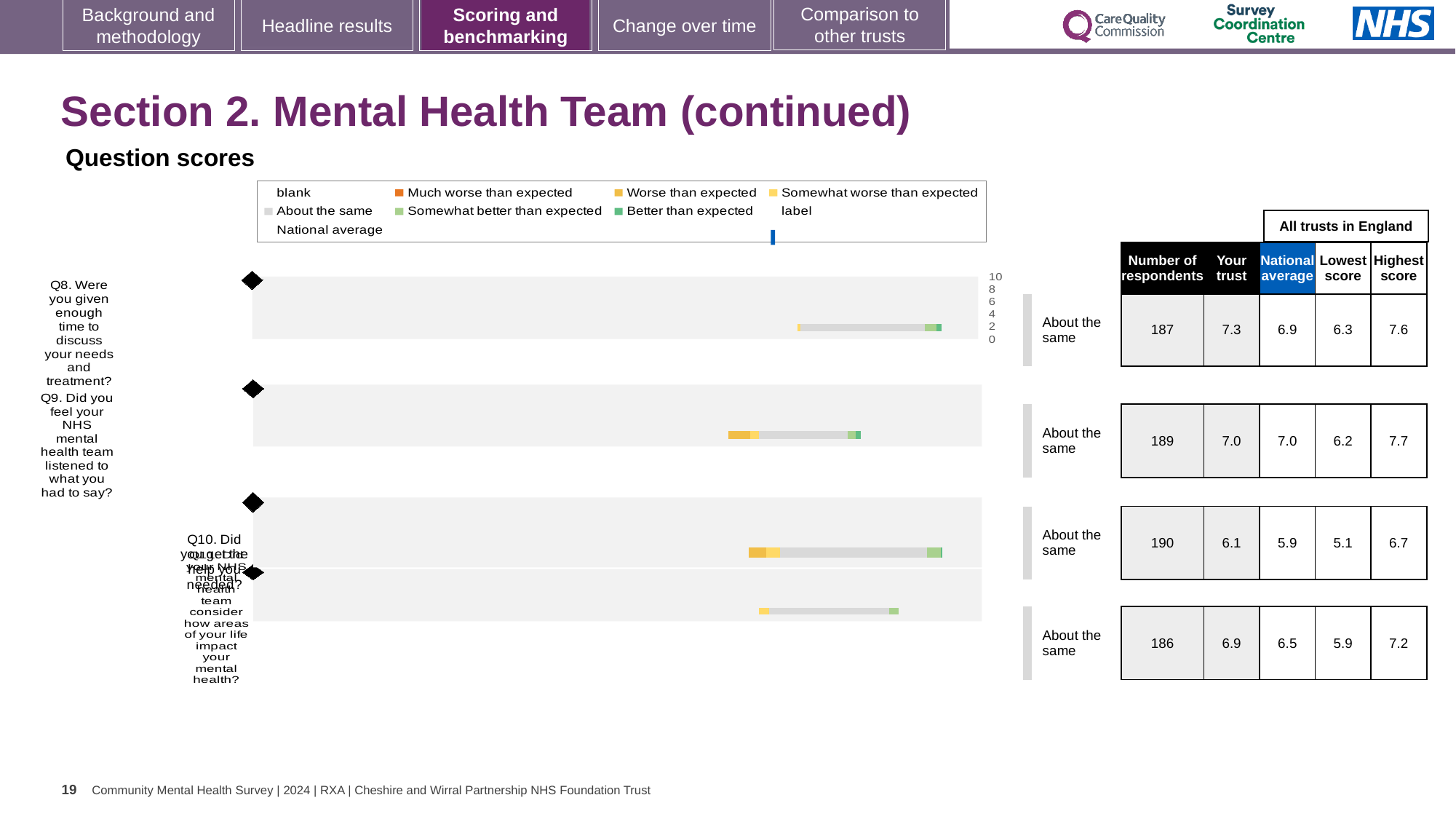
What is the 'Your trust' score shown in the bottom row of the table? 6.9 Is the 'Your trust' score for Q10 larger or smaller than the national average for Q10? larger Which question has the highest 'Your trust' score? Q8 What is the 'Your trust' score for Q8 (Were you given enough time to discuss your needs and treatment?)? 7.3 How many respondents answered Q10 (Did you get the help you needed?)? 190 What is the national average score for Q9 (Did you feel your NHS mental health team listened to what you had to say?)? 7.0 What kind of chart is used to show the question scores on this slide? bar chart What is the lowest score among all trusts in England for Q10? 5.1 What benchmark category is shown for Q9? About the same What is the highest score among all trusts in England for Q9? 7.7 Which question has the lowest 'Your trust' score? Q10 What is the difference between the 'Your trust' score and the national average for Q8? 0.4